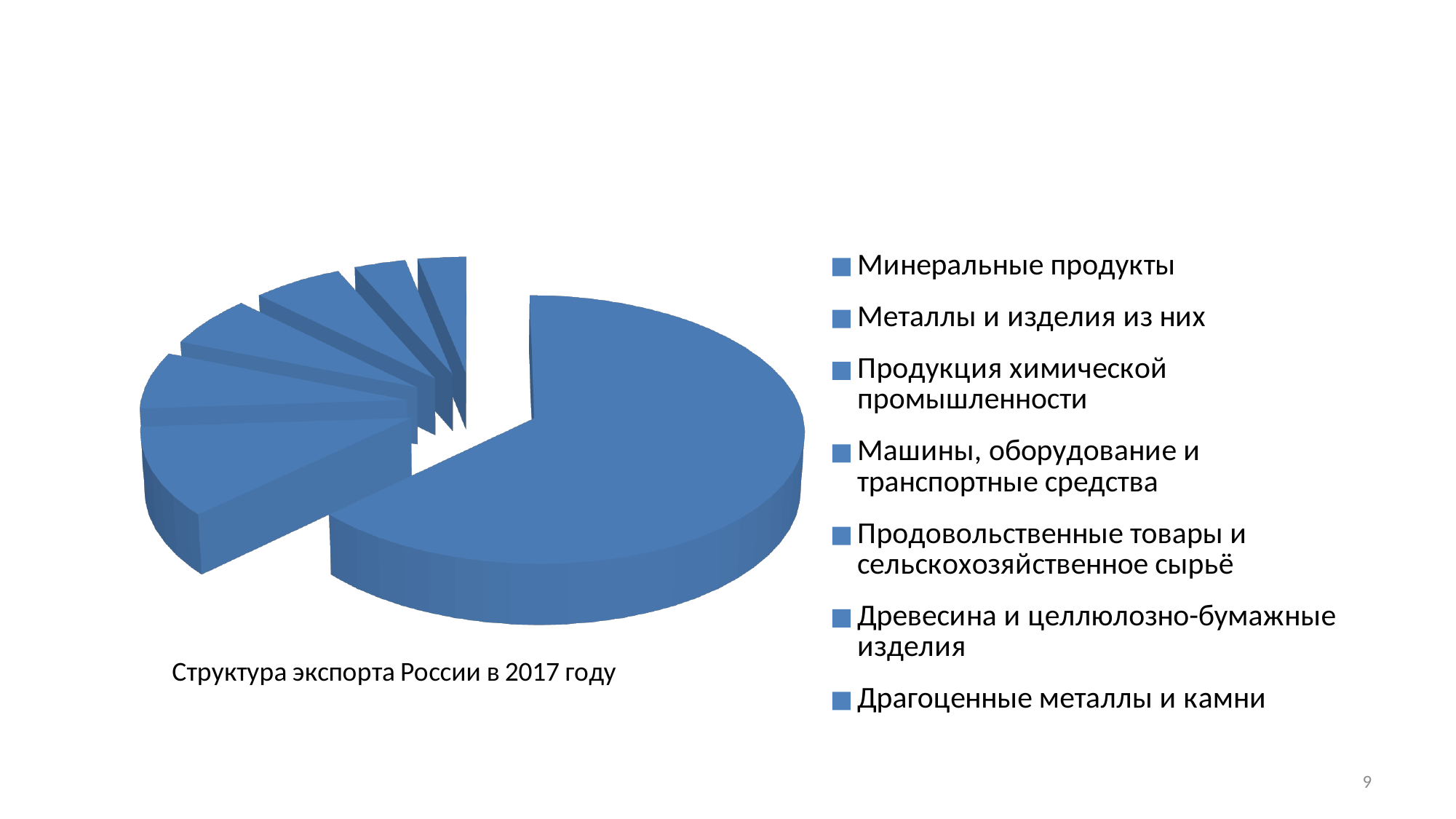
Is the largest slice of the pie chart greater or less than half of the whole pie? greater What is the title of the pie chart? Структура экспорта России в 2017 году What is the first entry listed in the legend of the pie chart? Минеральные продукты Is the largest slice of the pie chart larger or smaller than all the other slices combined? larger What kind of chart is shown on the slide? pie chart How many entries does the legend of the pie chart list? 7 How many slices does the pie chart have? 7